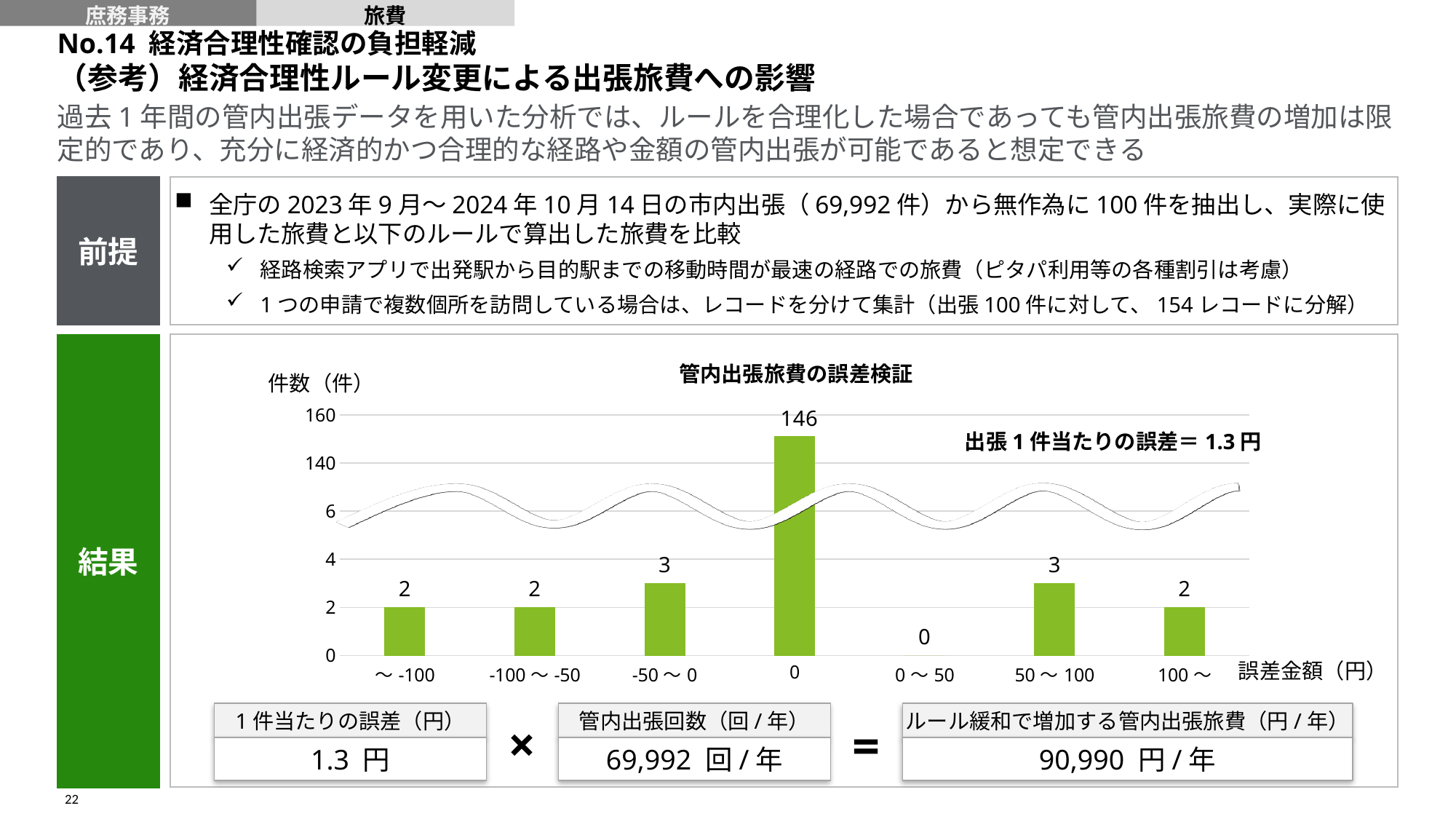
What is the label of the horizontal axis in the chart 管内出張旅費の誤差検証? 誤差金額（円） In the chart 管内出張旅費の誤差検証, what is the difference between the values for 0 and 50～100? 143 What type of chart is shown under 管内出張旅費の誤差検証? bar chart In the chart 管内出張旅費の誤差検証, what is the value for the category 100～? 2 In the chart 管内出張旅費の誤差検証, which category has the highest value? 0 In the chart 管内出張旅費の誤差検証, which category has the lowest value? 0～50 What is the label of the vertical axis in the chart 管内出張旅費の誤差検証? 件数（件） In the chart 管内出張旅費の誤差検証, what is the value for the category 0? 146 In the chart 管内出張旅費の誤差検証, what is the value for the category -50～0? 3 In the chart 管内出張旅費の誤差検証, which is larger, the value for -50～0 or the value for -100～-50? -50～0 How many categories are shown on the x axis of the chart 管内出張旅費の誤差検証? 7 In the chart 管内出張旅費の誤差検証, what is the value for the category 0～50? 0